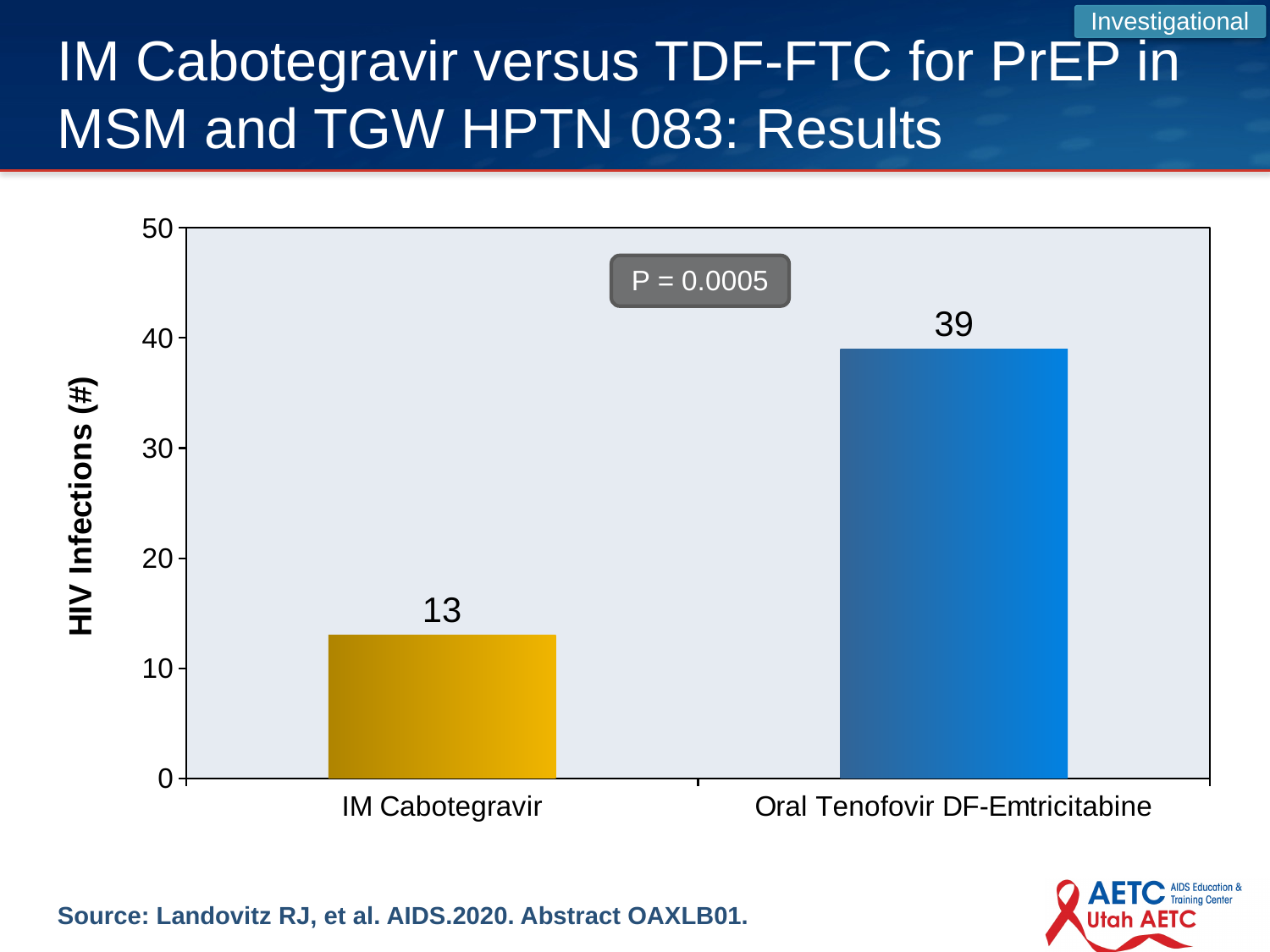
Which group has the lower number of HIV infections? IM Cabotegravir What is the difference in HIV infections between Oral Tenofovir DF-Emtricitabine and IM Cabotegravir? 26 What kind of chart is shown on the slide? Bar chart What P value is shown on the chart? P = 0.0005 What is the label of the y-axis? HIV Infections (#) Which has more HIV infections, IM Cabotegravir or Oral Tenofovir DF-Emtricitabine? Oral Tenofovir DF-Emtricitabine Which group has the higher number of HIV infections? Oral Tenofovir DF-Emtricitabine Is the value for Oral Tenofovir DF-Emtricitabine greater or less than 30? greater How many categories are plotted on the chart? 2 How many HIV infections are shown for Oral Tenofovir DF-Emtricitabine? 39 Is the value for IM Cabotegravir greater or less than 20? less How many HIV infections are shown for IM Cabotegravir? 13